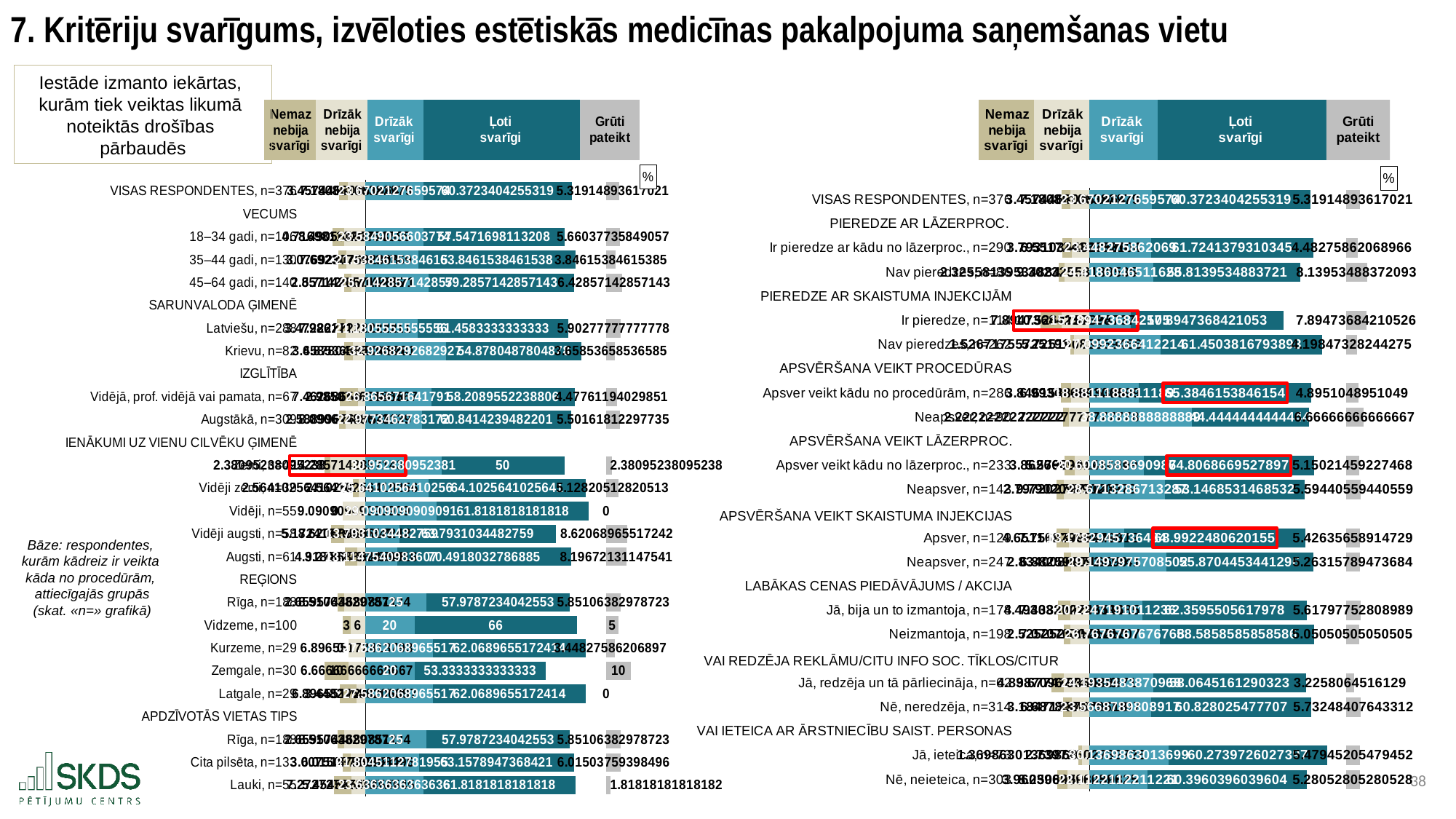
On the left chart, what is the 'Grūti pateikt' value for Latgale, n=29? 0 What kind of chart is shown on the right side of the slide? Stacked bar chart On the left chart, what is the 'Ļoti svarīgi' value for Vidzeme, n=100? 66 On the left chart, which is larger for Vidzeme, n=100: the 'Ļoti svarīgi' value or the 'Drīzāk svarīgi' value? Ļoti svarīgi On the right chart, what is the 'Grūti pateikt' value for 'Ir pieredze' under Pieredze ar skaistuma injekcijām? 7.89473684210526 On the left chart, what is the 'Drīzāk svarīgi' value for Vidzeme, n=100? 20 On the right chart, what is the 'Ļoti svarīgi' value for 'Apsver veikt kādu no procedūrām, n=286'? 65.3846153846154 On the left chart, what is the 'Grūti pateikt' value for Zemgale, n=30? 10 How many series does the legend of the left chart list? 5 On the right chart, what is the 'Ļoti svarīgi' value for 'Apsver, n=129' under Apsvēršana veikt skaistuma injekcijas? 68.9922480620155 On the left chart, what is the difference between the 'Ļoti svarīgi' and 'Drīzāk svarīgi' values for Vidzeme, n=100? 46 On the left chart, what is the 'Ļoti svarīgi' value for Zemgale, n=30? 53.3333333333333